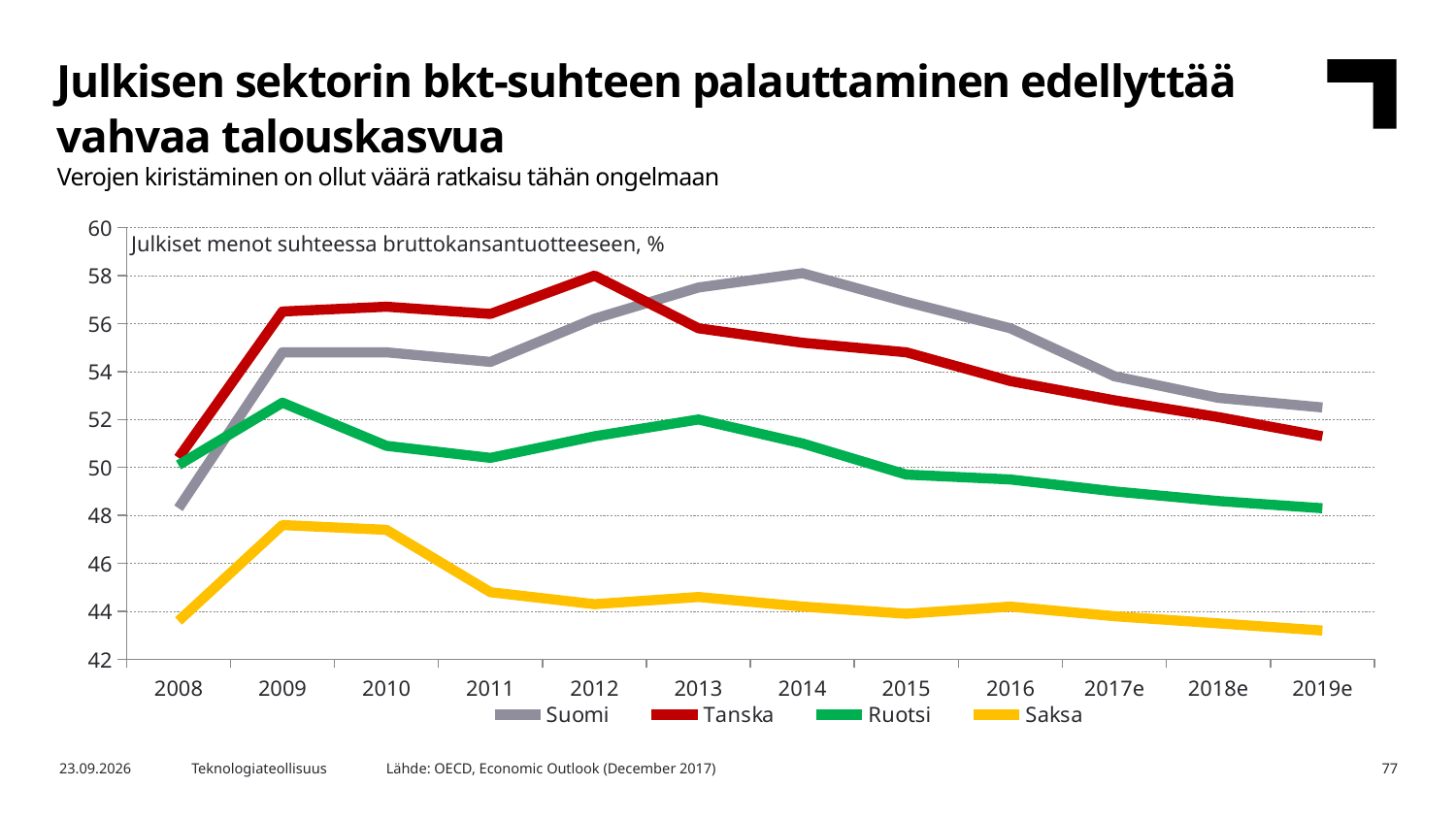
How many years are shown on the x axis? 12 Is the value for Ruotsi in 2019e greater or less than 50? less Is the value for Suomi in 2014 greater or less than 56? greater Which series has the lowest values across all years shown? Saksa Is the value for Saksa in 2009 greater or less than 46? greater How many series does the legend list? 4 Does the Suomi line rise or fall from 2014 to 2019e? fall In which year does the Tanska line reach its highest value? 2012 In 2009, which is larger: the value for Tanska or the value for Suomi? Tanska Which series has the highest value in 2014? Suomi What is the title printed inside the chart area? Julkiset menot suhteessa bruttokansantuotteeseen, % What kind of chart is shown on the slide? line chart